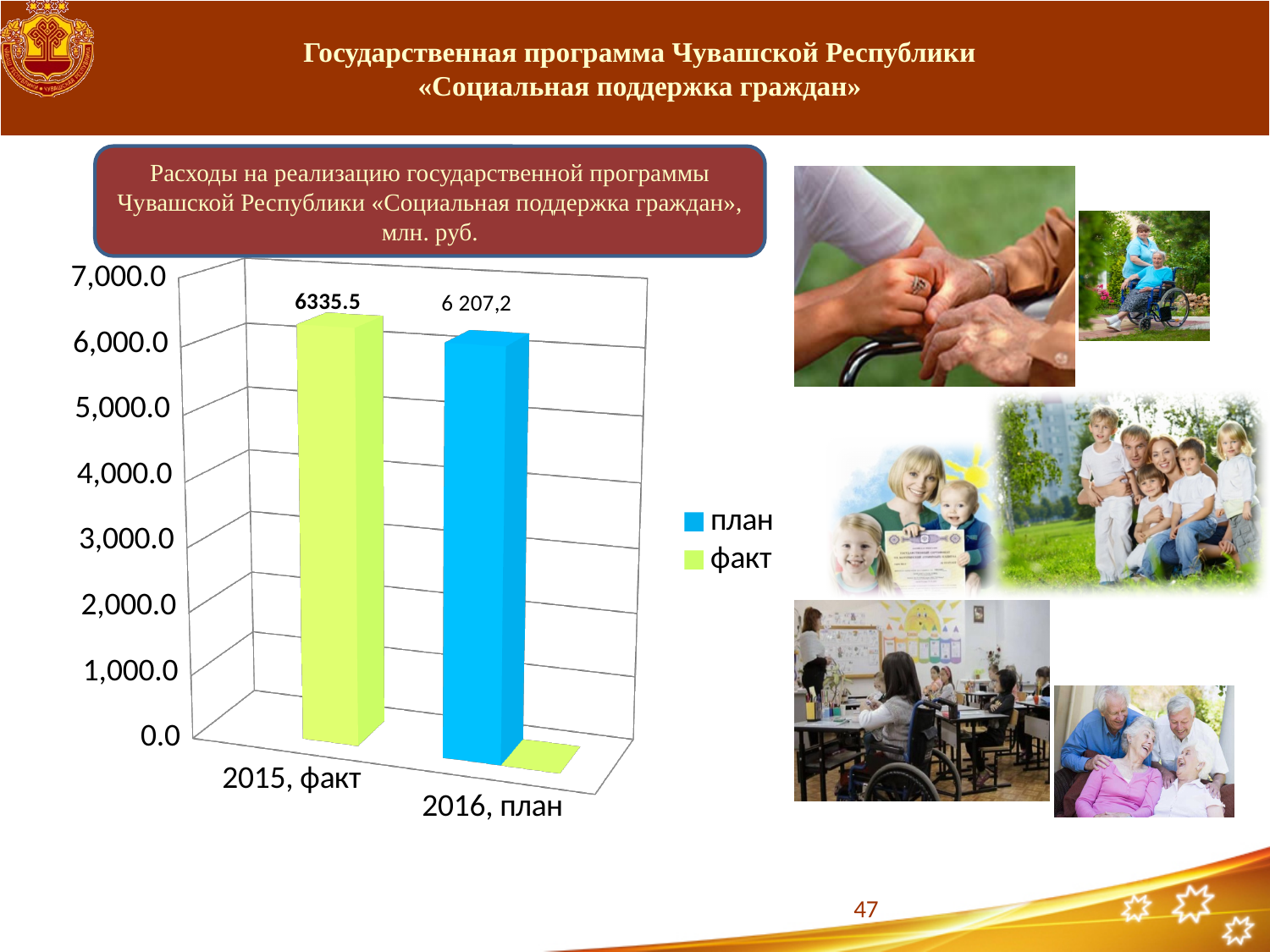
What is the difference between the value for 2015, факт and the value for 2016, план? 128.3 What is the value shown for 2015, факт? 6335.5 What kind of chart is shown on the slide? bar chart Which category has the lowest value on the chart? 2016, план How many series does the legend list? 2 Do the values rise or fall from 2015, факт to 2016, план? fall What is the value shown for 2016, план? 6 207,2 Which category has the higher value, 2015, факт or 2016, план? 2015, факт Is the value for 2015, факт greater or less than 6,000.0? greater Which category has the highest value on the chart? 2015, факт Is the value for 2016, план greater or less than 7,000.0? less How many categories are shown on the x axis of the chart? 2